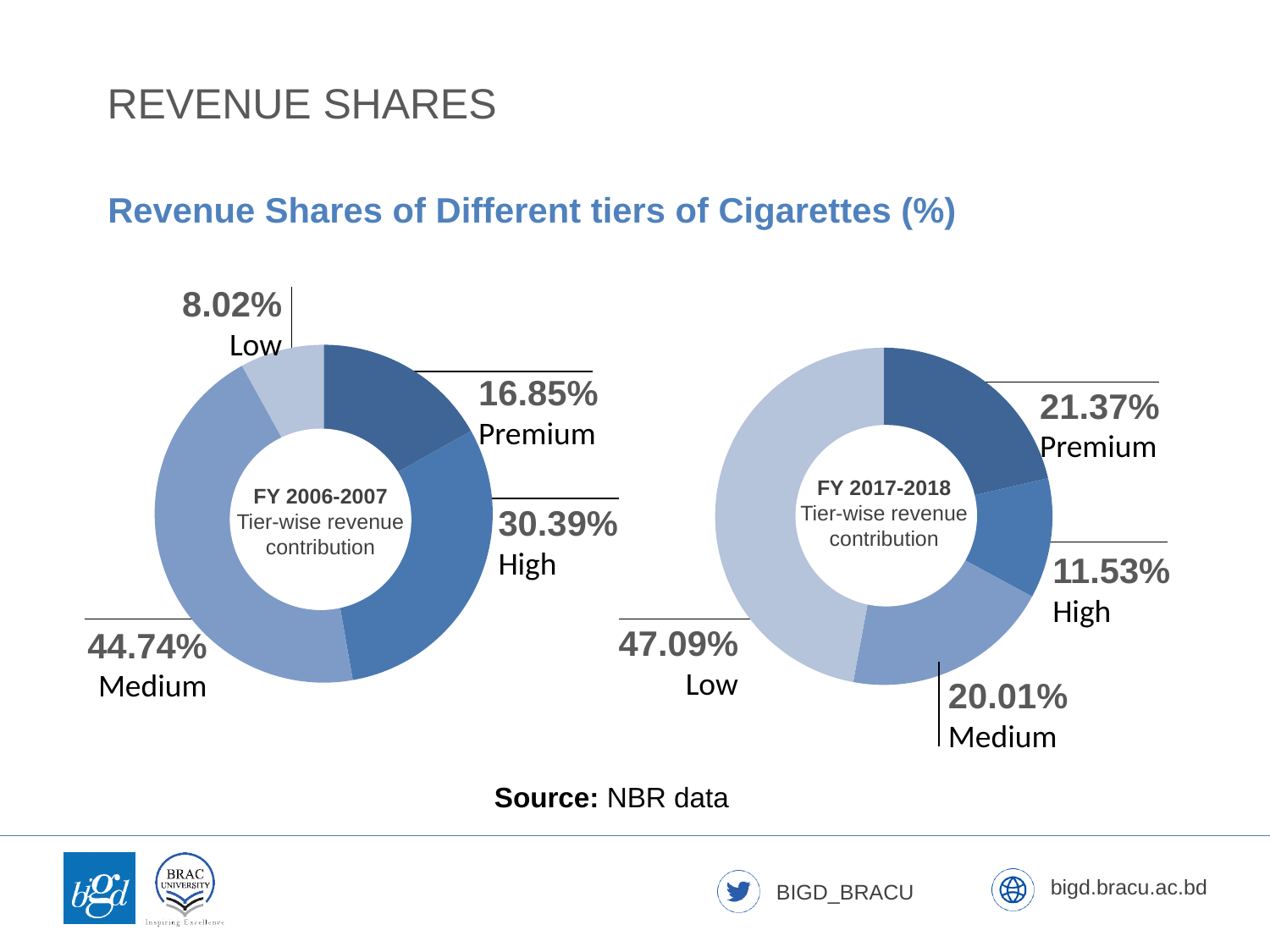
In the FY 2006-2007 chart, which tier has the smallest revenue share? Low In the FY 2017-2018 chart, which tier has the largest revenue share? Low In the FY 2017-2018 chart, what is the difference between the Premium and Medium revenue shares? 1.36% In the FY 2017-2018 chart, what is the revenue share of the Low tier? 47.09% What type of chart is used on this slide to show the revenue shares? Doughnut (pie) chart How many tiers are shown in the FY 2006-2007 chart? 4 In the FY 2006-2007 chart, which tier has a larger revenue share, High or Premium? High In the FY 2006-2007 chart, which tier has the largest revenue share? Medium In the FY 2006-2007 chart, what is the revenue share of the Medium tier? 44.74% In the FY 2017-2018 chart, what is the revenue share of the High tier? 11.53% In the FY 2006-2007 chart, what is the revenue share of the Premium tier? 16.85% In the FY 2017-2018 chart, which tier has the smallest revenue share? High